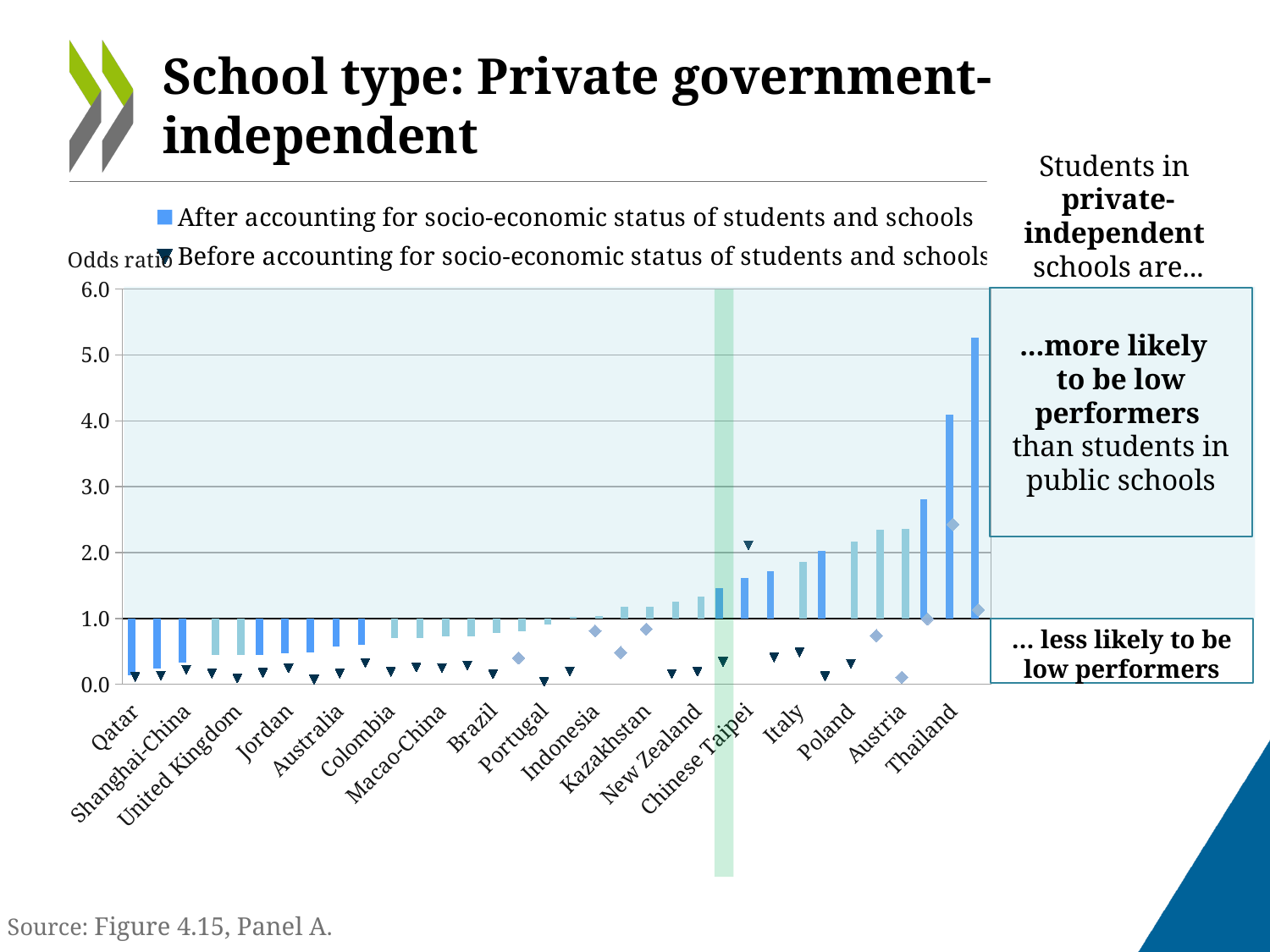
Is the tallest bar in the chart greater or less than 5.0? greater What kind of chart is shown on the slide? Bar chart What is the first legend entry of the chart? After accounting for socio-economic status of students and schools What is the label on the vertical axis of the chart? Odds ratio Do the bar values generally rise or fall from left to right along the x axis? rise Which country is the first category on the left of the x axis? Qatar Is the bar value for Qatar greater or less than 1.0? less How many series does the chart legend list? 2